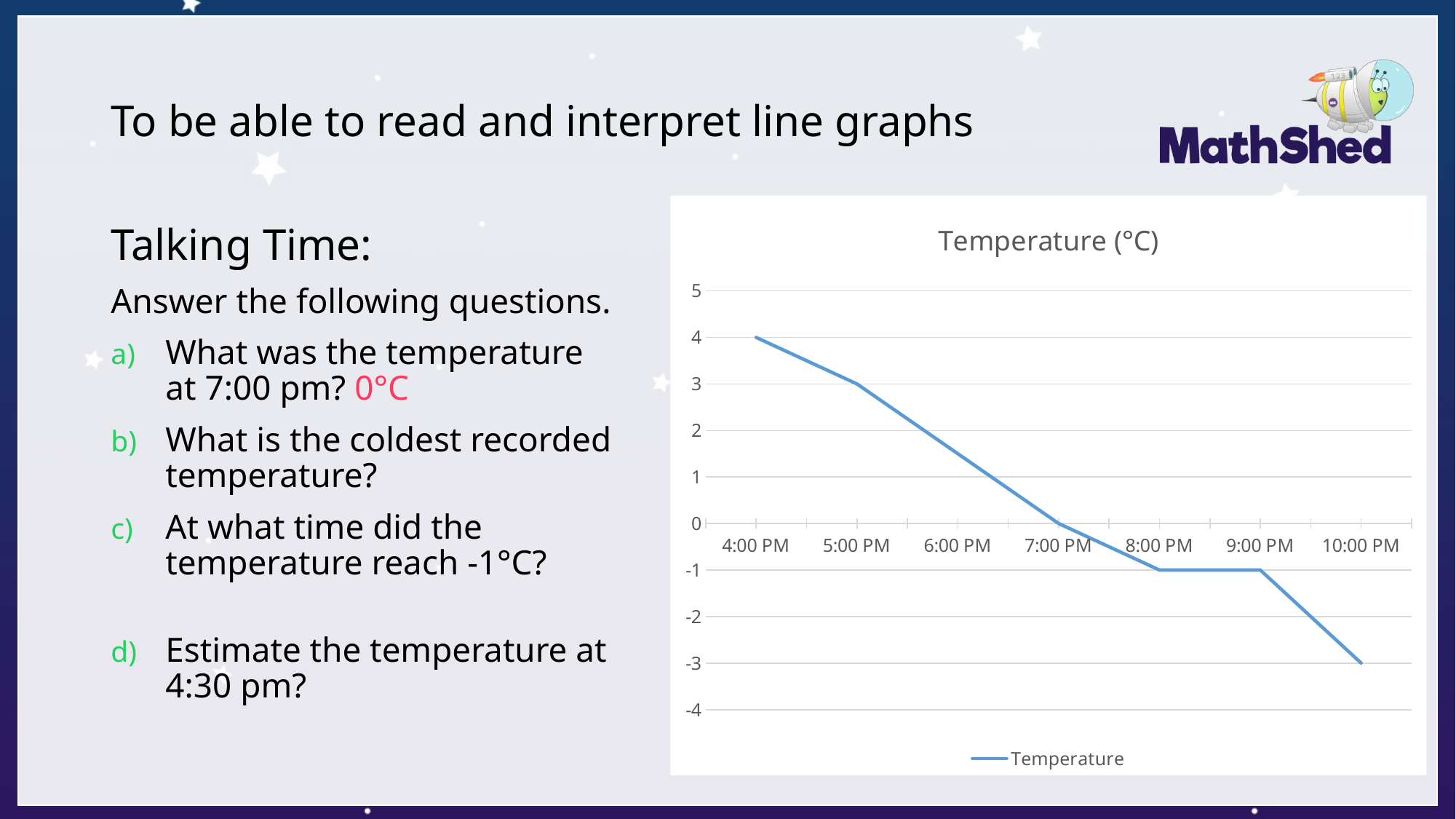
What kind of chart is shown on the slide? line chart At which time was the temperature highest? 4:00 PM What was the temperature at 5:00 PM? 3 Is the temperature at 6:00 PM greater or less than 2? less What was the temperature at 10:00 PM? -3 How many time points are plotted on the chart? 7 Does the temperature rise or fall from 4:00 PM to 10:00 PM? fall What was the temperature at 4:00 PM? 4 Which is higher, the temperature at 5:00 PM or at 8:00 PM? 5:00 PM What was the temperature at 8:00 PM? -1 What is the difference between the temperature at 4:00 PM and the temperature at 10:00 PM? 7 At which time was the temperature lowest? 10:00 PM